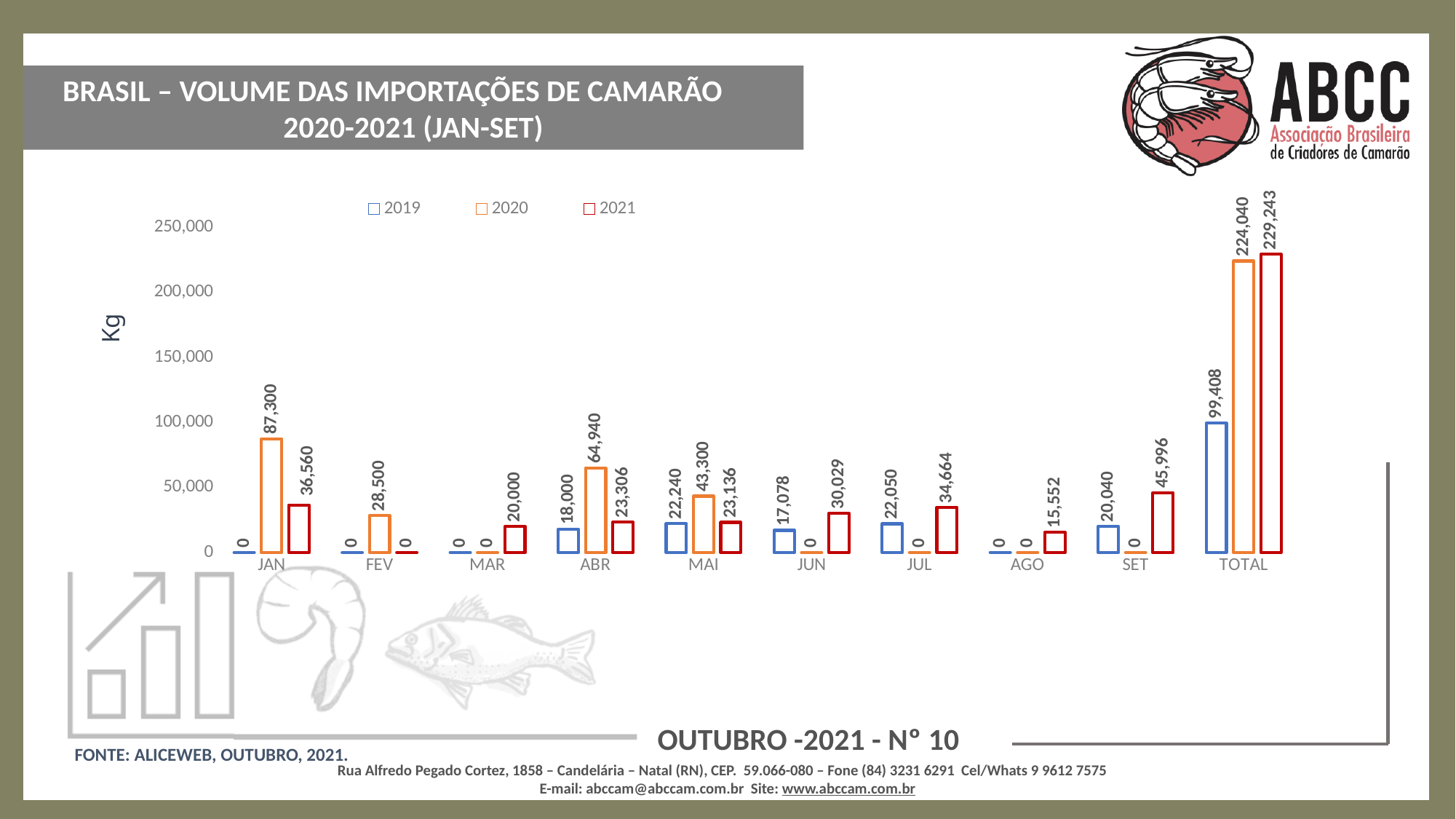
Which month has the highest 2021 value (excluding TOTAL)? SET What unit is shown on the y axis label? Kg How many categories are shown on the x axis? 10 What is the difference between the 2021 and 2020 TOTAL values? 5,203 How many series does the legend list? 3 What is the 2021 value for SET? 45,996 What is the 2019 value for TOTAL? 99,408 What is the 2020 value for JAN? 87,300 Which is larger for ABR: the 2020 value or the 2021 value? 2020 Which series has the lowest TOTAL value? 2019 What kind of chart is shown on the slide? bar chart Is the 2020 TOTAL value greater or less than 200,000? greater